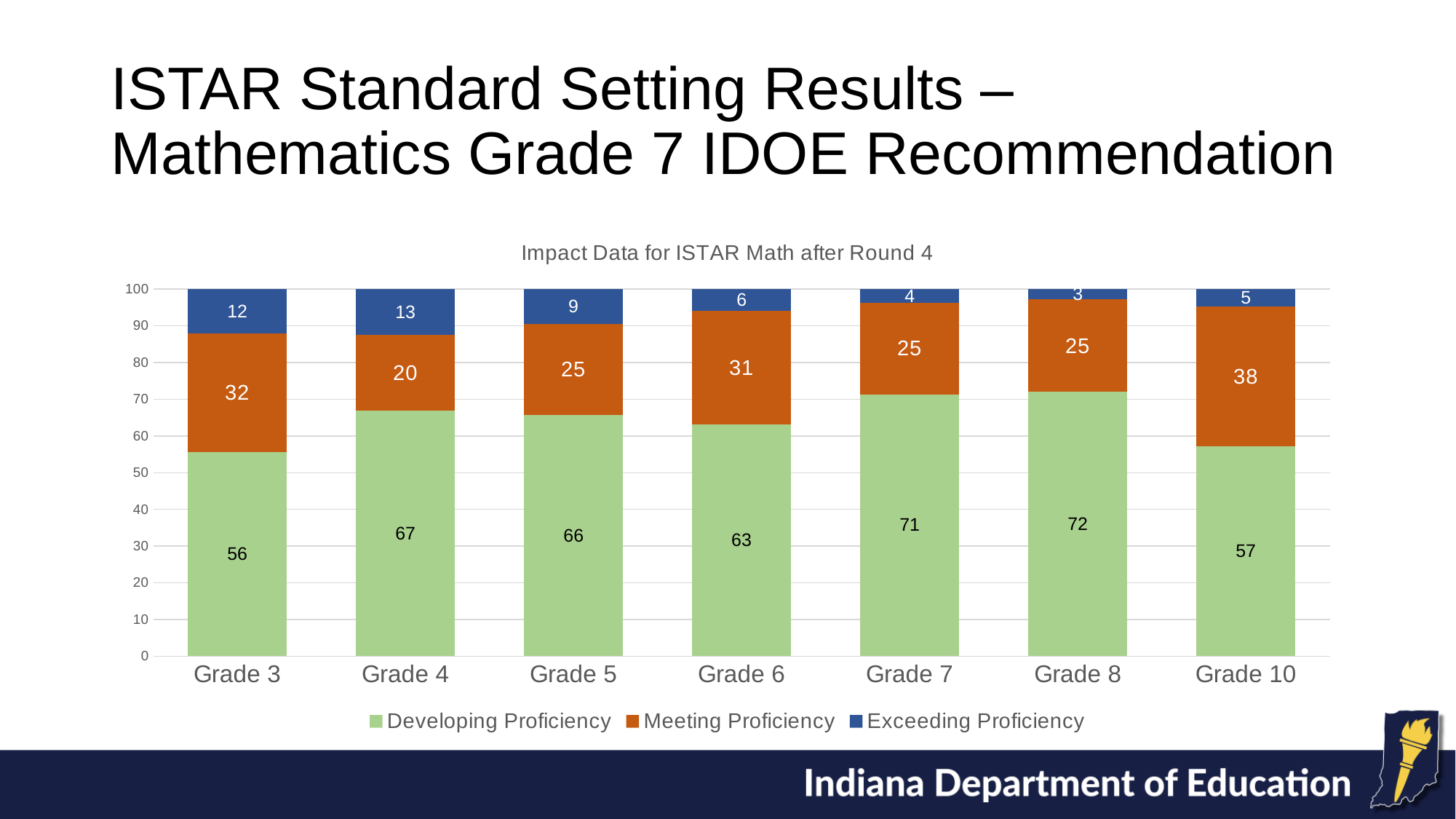
Which is larger, the Exceeding Proficiency value for Grade 5 or for Grade 6? Grade 5 What is the difference between the Meeting Proficiency values for Grade 3 and Grade 4? 12 How many series does the legend list? 3 What is the Developing Proficiency value for Grade 6? 63 What is the Meeting Proficiency value for Grade 10? 38 What is the Exceeding Proficiency value for Grade 4? 13 Which grade has the highest Developing Proficiency value? Grade 8 Which grade has the lowest Exceeding Proficiency value? Grade 8 What kind of chart is shown on the slide? Stacked bar chart How many grade categories are shown on the x axis? 7 What is the title of the chart? Impact Data for ISTAR Math after Round 4 Which grade has the highest Meeting Proficiency value? Grade 10